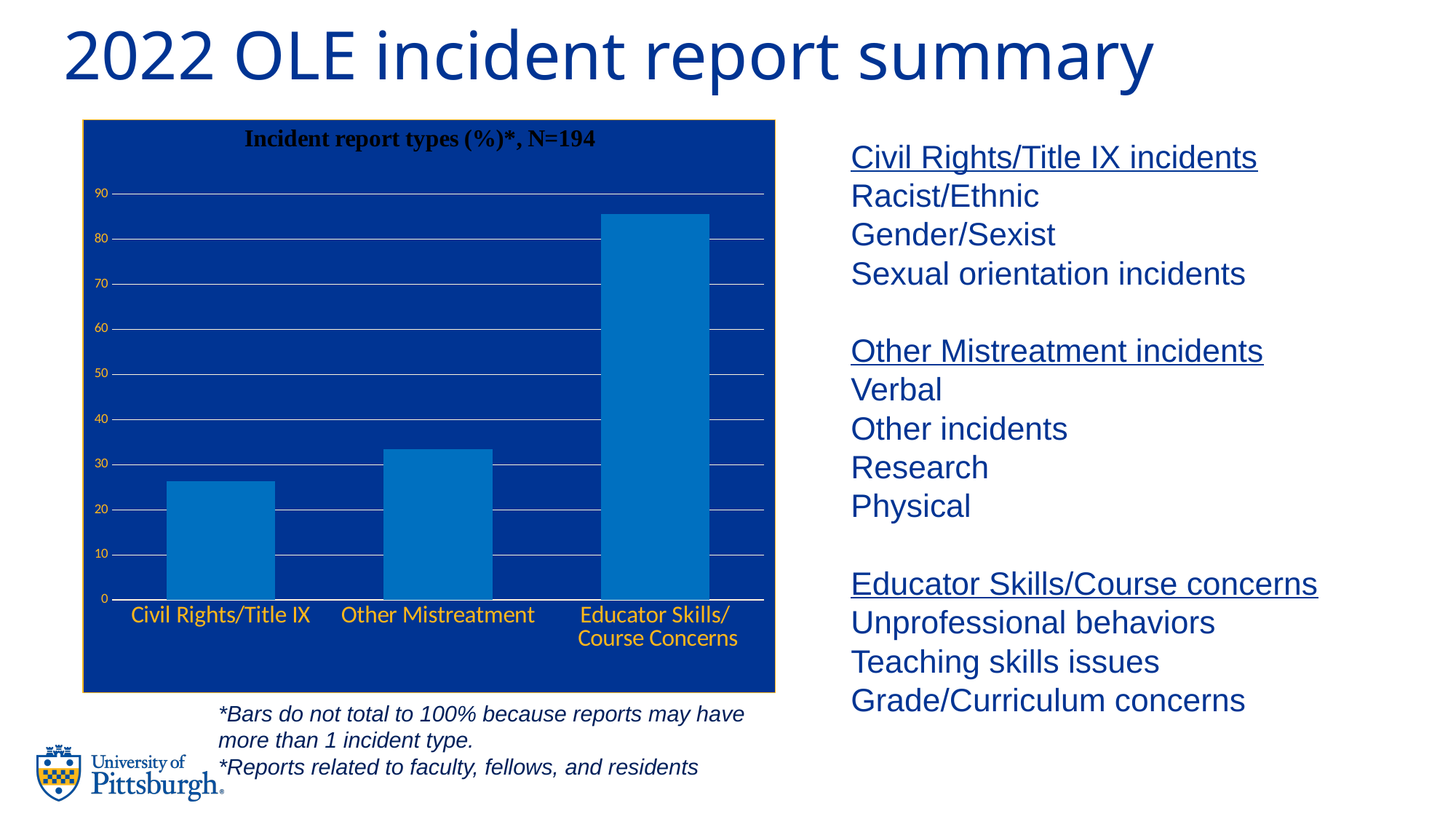
What type of chart is shown on the slide? bar chart Is the value for Educator Skills/Course Concerns greater or less than 80? greater Do the bar values rise or fall from left to right across the x axis? rise Which is larger, the value for Other Mistreatment or the value for Civil Rights/Title IX? Other Mistreatment Is the value for Other Mistreatment greater or less than 30? greater How many categories are shown on the x axis of the chart? 3 What is the title of the chart? Incident report types (%)*, N=194 What is the sample size (N) stated in the chart title? 194 Is the value for Educator Skills/Course Concerns greater or less than 90? less Which category has the highest bar in the chart? Educator Skills/Course Concerns Which category has the lowest bar in the chart? Civil Rights/Title IX